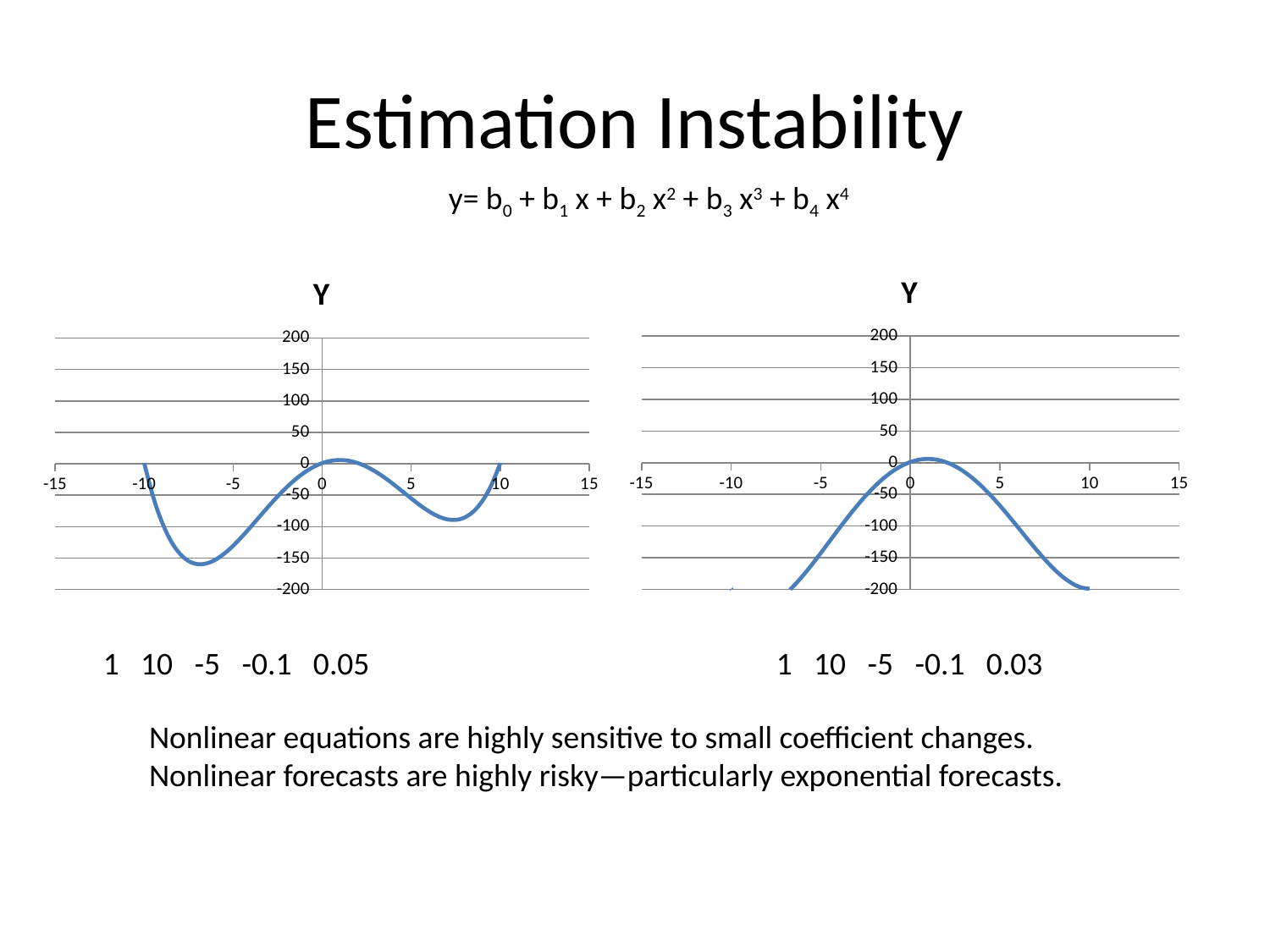
What is the highest tick shown on the vertical axis of the left chart? 200 In the right chart, is the value at x = 10 greater or less than -100? less What is the title of the right chart? Y At x = 10, which chart shows the higher value, the left chart or the right chart? left chart How many charts are on the slide? 2 In the left chart, is the value at x = -10 greater or less than -50? greater In the left chart, is the value at x = 10 greater or less than -50? greater In the left chart, do the values rise or fall as x increases from -7 to 0? rise In the right chart, do the values rise or fall as x increases from 0 to 10? fall What kind of chart is the left chart? line chart